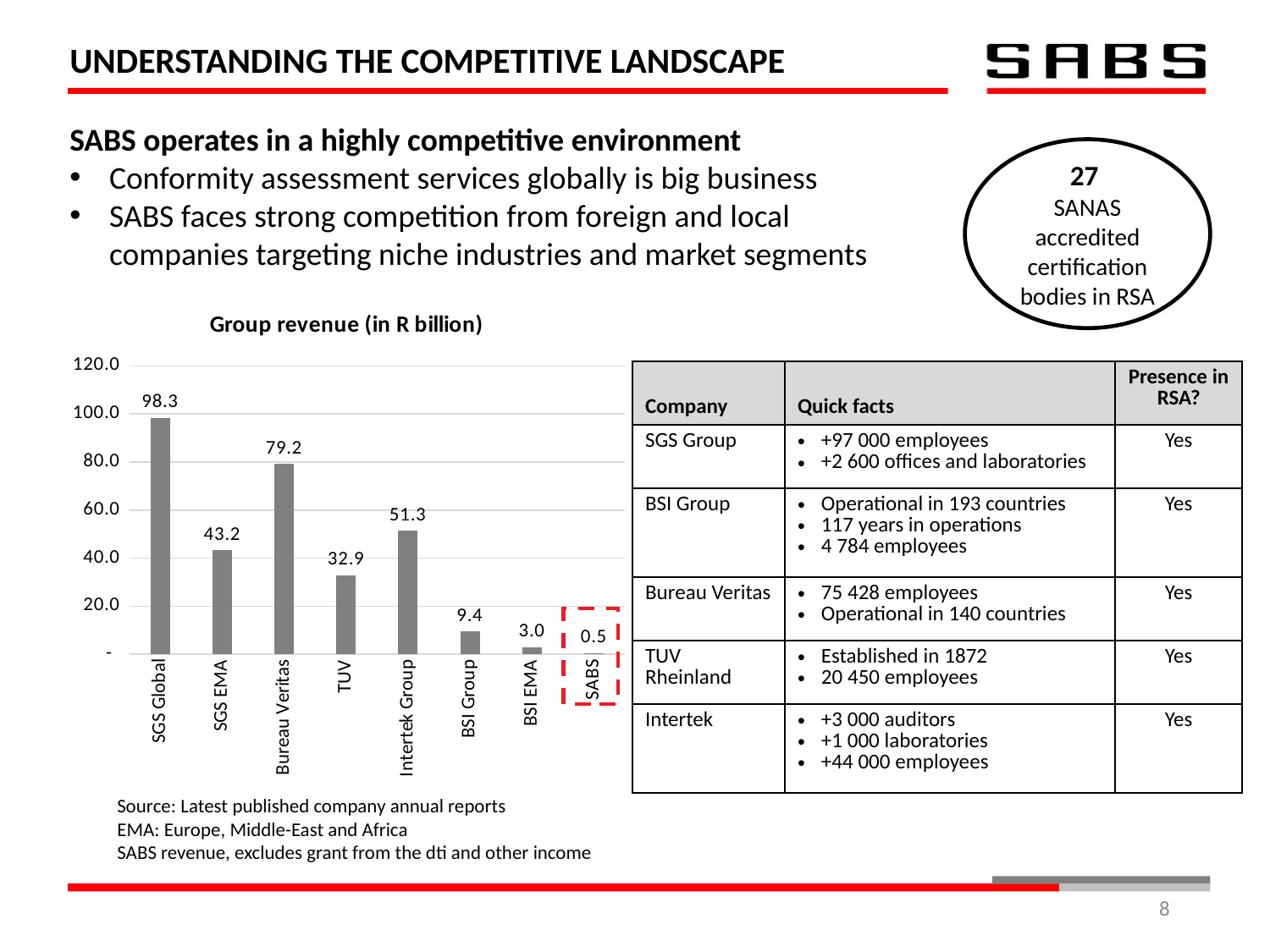
What is the difference in group revenue (in R billion) between SGS Global and SGS EMA? 55.1 What is the group revenue (in R billion) for Bureau Veritas? 79.2 What is the group revenue (in R billion) for SABS? 0.5 Which has a higher group revenue, TUV or Intertek Group? Intertek Group How many companies are shown in the group revenue chart? 8 What is the group revenue (in R billion) for SGS Global? 98.3 Is the group revenue for BSI Group greater or less than 20.0? less What type of chart is used to show group revenue? bar chart Which company has the lowest group revenue in the chart? SABS What is the title of the chart? Group revenue (in R billion) Which company has the highest group revenue in the chart? SGS Global What is the group revenue (in R billion) for Intertek Group? 51.3